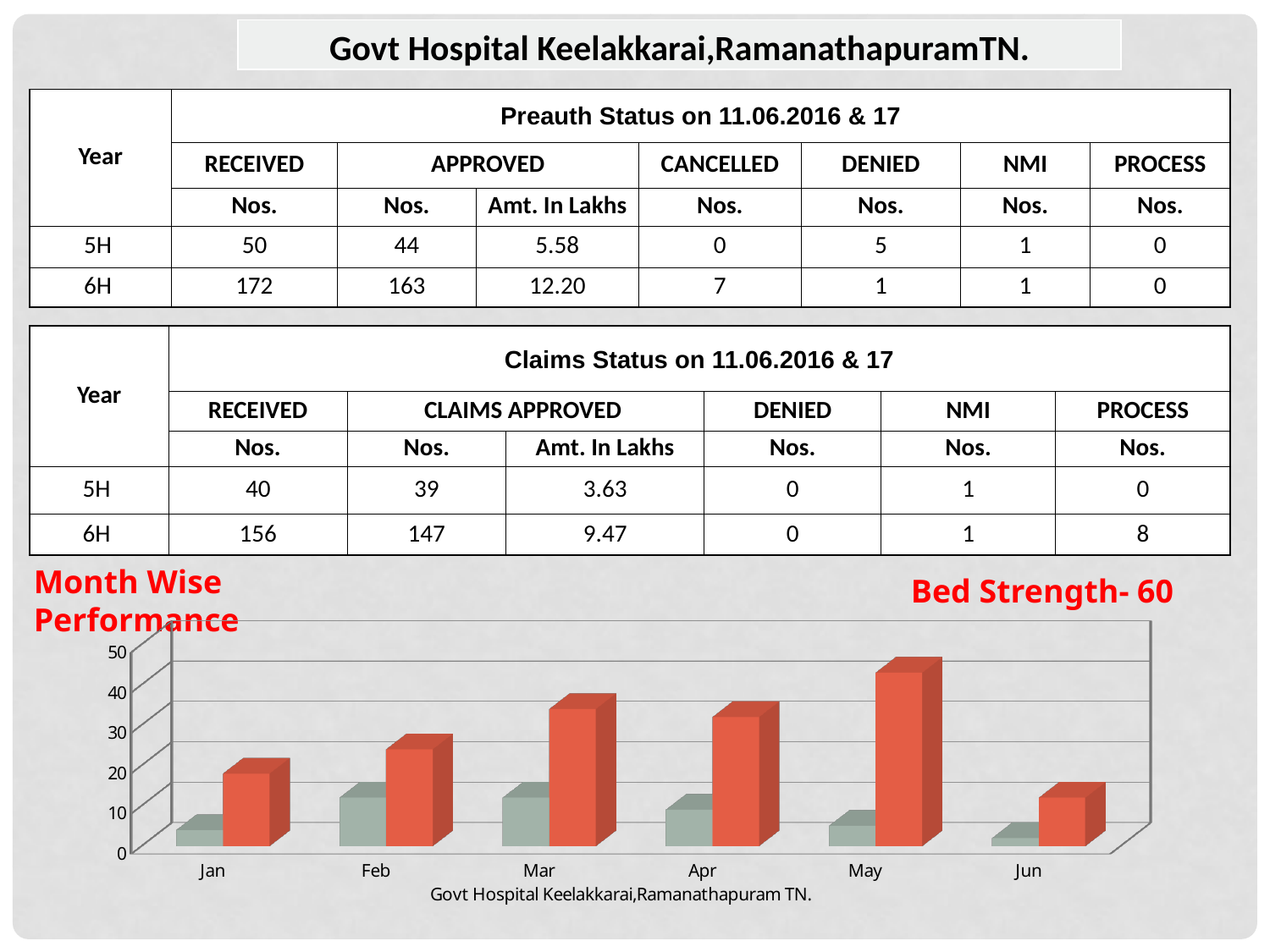
In the Month Wise Performance chart, is the green bar for Jan greater or less than 10? less In the Month Wise Performance chart, which month has the tallest red bar? May In the Month Wise Performance chart, which month has the shortest green bar? Jun What kind of chart is shown under the heading 'Month Wise Performance'? bar chart In the Month Wise Performance chart, which is larger, the red bar for Feb or the red bar for May? May In the Month Wise Performance chart, which is larger, the green bar for Jan or the green bar for Feb? Feb In the Month Wise Performance chart, is the red bar for Mar greater or less than 30? greater How many months are shown on the x axis of the Month Wise Performance chart? 6 In the Month Wise Performance chart, which month has the shortest red bar? Jun What is the highest value shown on the vertical axis of the Month Wise Performance chart? 50 In the Month Wise Performance chart, is the red bar for May greater or less than 40? greater